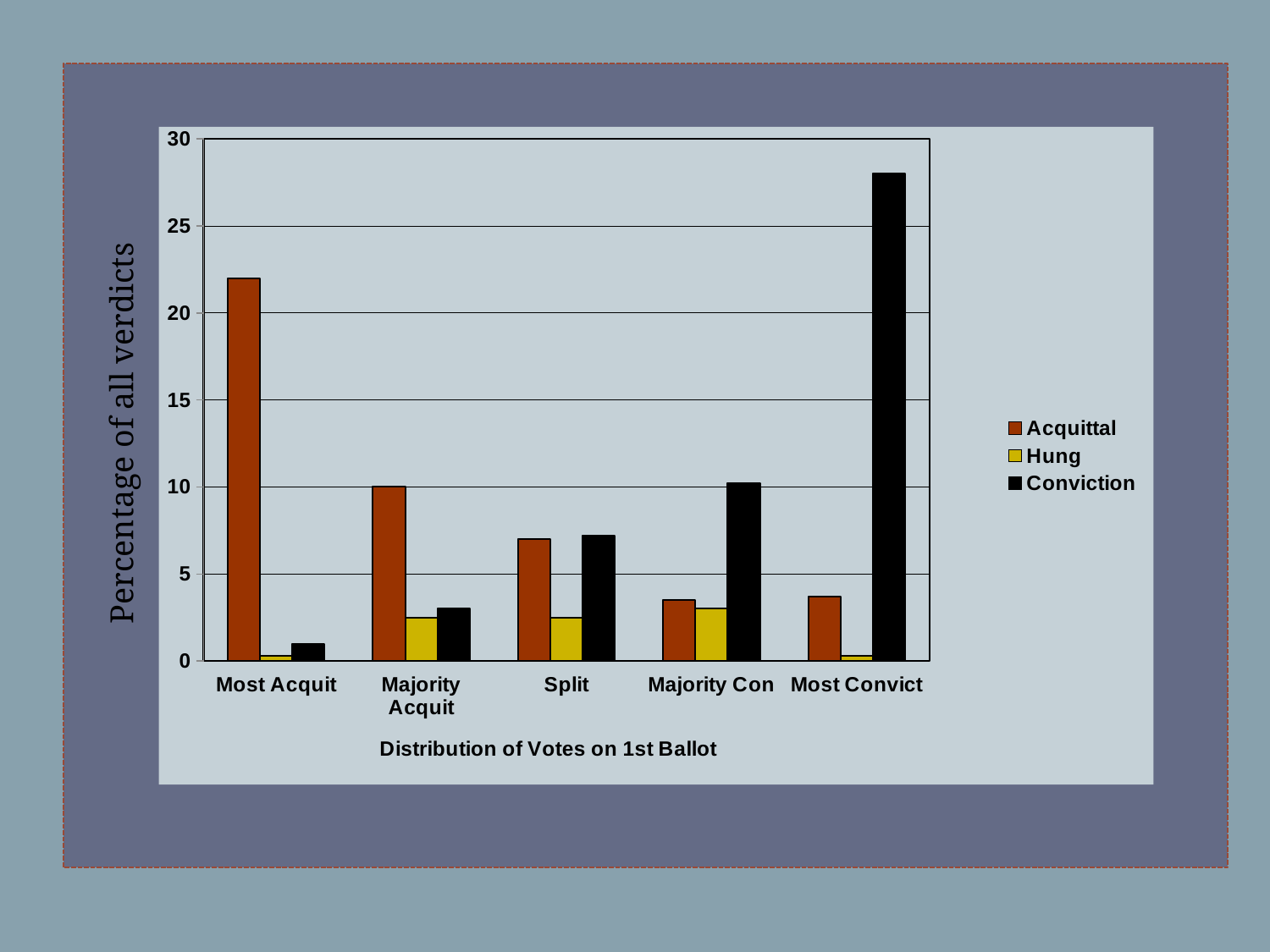
Is the Conviction value for Majority Acquit greater or less than 5? less Which category has the highest Acquittal bar? Most Acquit Is the Acquittal value for Most Acquit greater or less than 20? greater How many series does the legend list? 3 Which category has the highest Conviction bar? Most Convict How many categories are shown along the x axis? 5 Which is larger: the Acquittal bar for Most Acquit or the Conviction bar for Most Convict? Conviction bar for Most Convict In the Majority Con category, which is larger: the Conviction bar or the Acquittal bar? Conviction What is the title of the x axis? Distribution of Votes on 1st Ballot Is the Conviction value for Most Convict greater or less than 25? greater What kind of chart is shown on the slide? bar chart What is the title of the y axis? Percentage of all verdicts